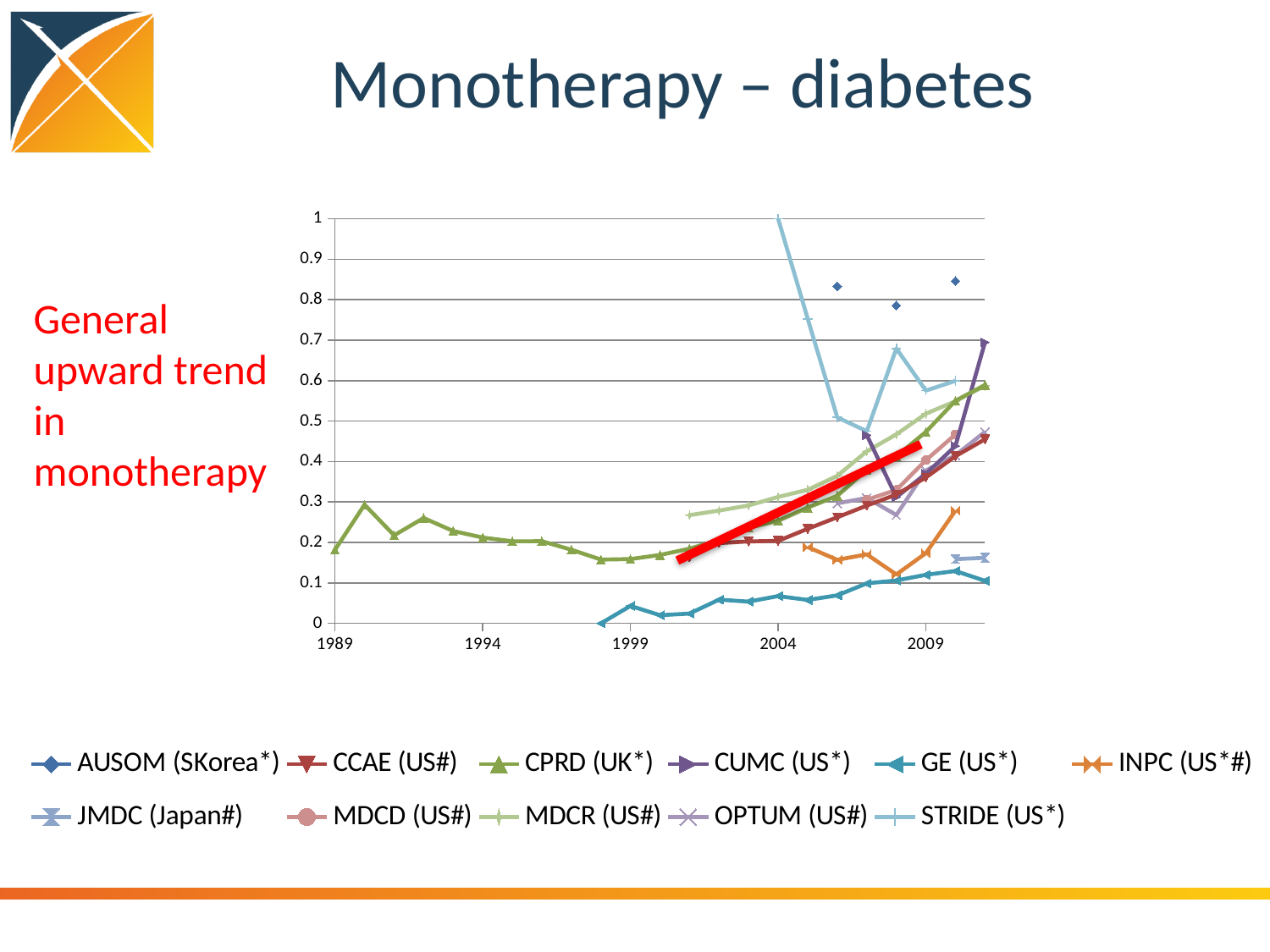
Is the value for AUSOM (SKorea*) in 2006 greater or less than 0.7? greater What does the red annotation text to the left of the chart say? General upward trend in monotherapy What is the title of the slide containing the chart? Monotherapy – diabetes How many series does the legend list? 11 What kind of chart is shown on the slide? line chart Is the value for STRIDE (US*) in 2004 greater or less than 0.9? greater Which is larger in 2004: the value for STRIDE (US*) or the value for CPRD (UK*)? STRIDE (US*) Is the value for CPRD (UK*) in 1999 greater or less than 0.2? less Which series has the lowest values on the chart? GE (US*) Does the GE (US*) series generally rise or fall from 1998 to 2011? rise Which series reaches the highest value on the chart? STRIDE (US*)